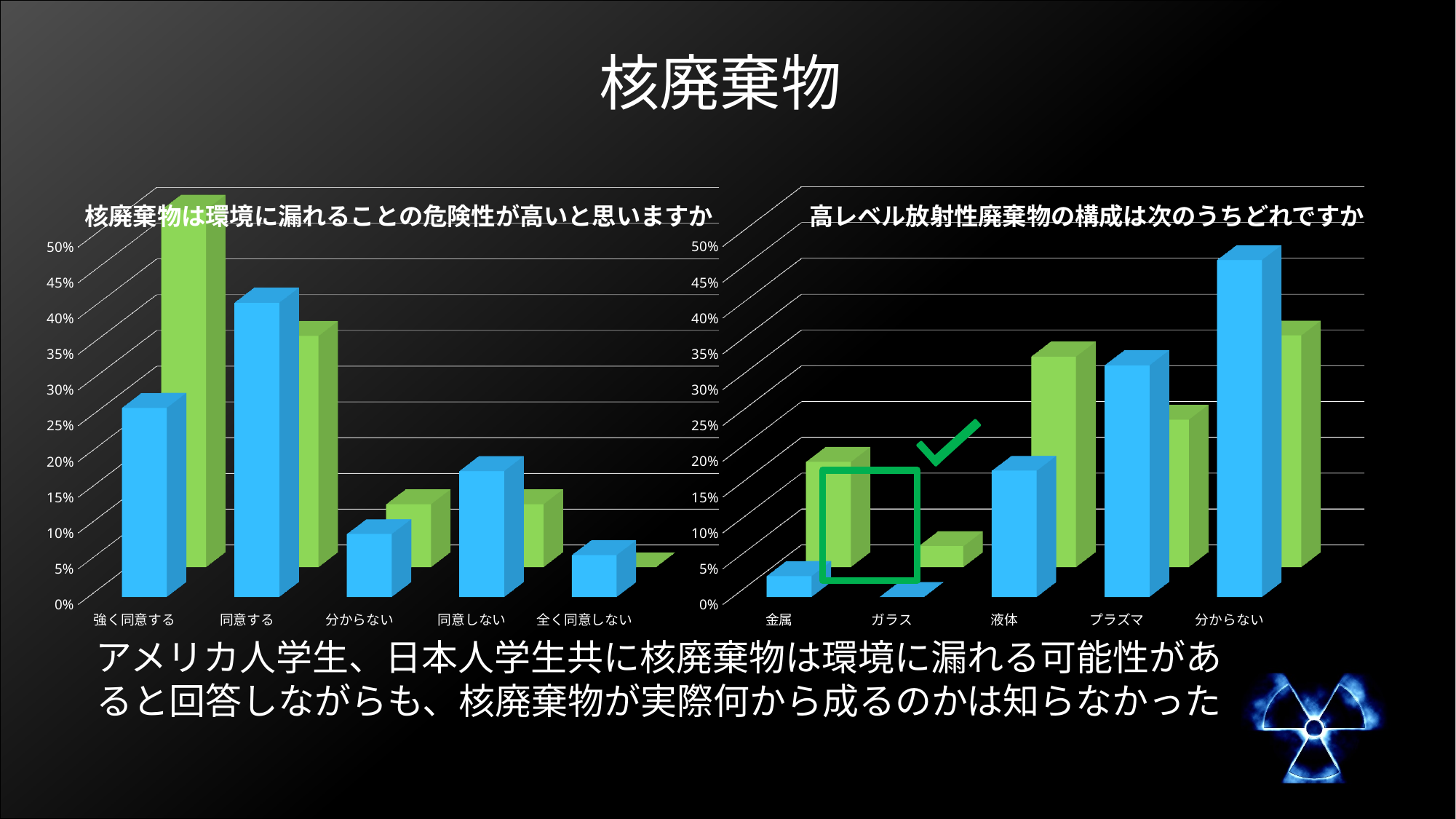
In the right chart titled 高レベル放射性廃棄物の構成は次のうちどれですか, which category has the tallest blue bar? 分からない In the right chart titled 高レベル放射性廃棄物の構成は次のうちどれですか, is the blue bar for 分からない greater or less than 40%? greater How many categories are shown on the x axis of the right chart titled 高レベル放射性廃棄物の構成は次のうちどれですか? 5 In the left chart titled 核廃棄物は環境に漏れることの危険性が高いと思いますか, which category has the shortest green bar? 全く同意しない What kind of chart is the left chart titled 核廃棄物は環境に漏れることの危険性が高いと思いますか? bar chart In the right chart titled 高レベル放射性廃棄物の構成は次のうちどれですか, which category is marked with a green check mark and box? ガラス In the right chart titled 高レベル放射性廃棄物の構成は次のうちどれですか, is the blue bar for 金属 greater or less than 10%? less In the left chart titled 核廃棄物は環境に漏れることの危険性が高いと思いますか, which category has the tallest green bar? 強く同意する In the left chart titled 核廃棄物は環境に漏れることの危険性が高いと思いますか, which category has the tallest blue bar? 同意する In the right chart titled 高レベル放射性廃棄物の構成は次のうちどれですか, which category has the shortest green bar? ガラス How many categories are shown on the x axis of the left chart titled 核廃棄物は環境に漏れることの危険性が高いと思いますか? 5